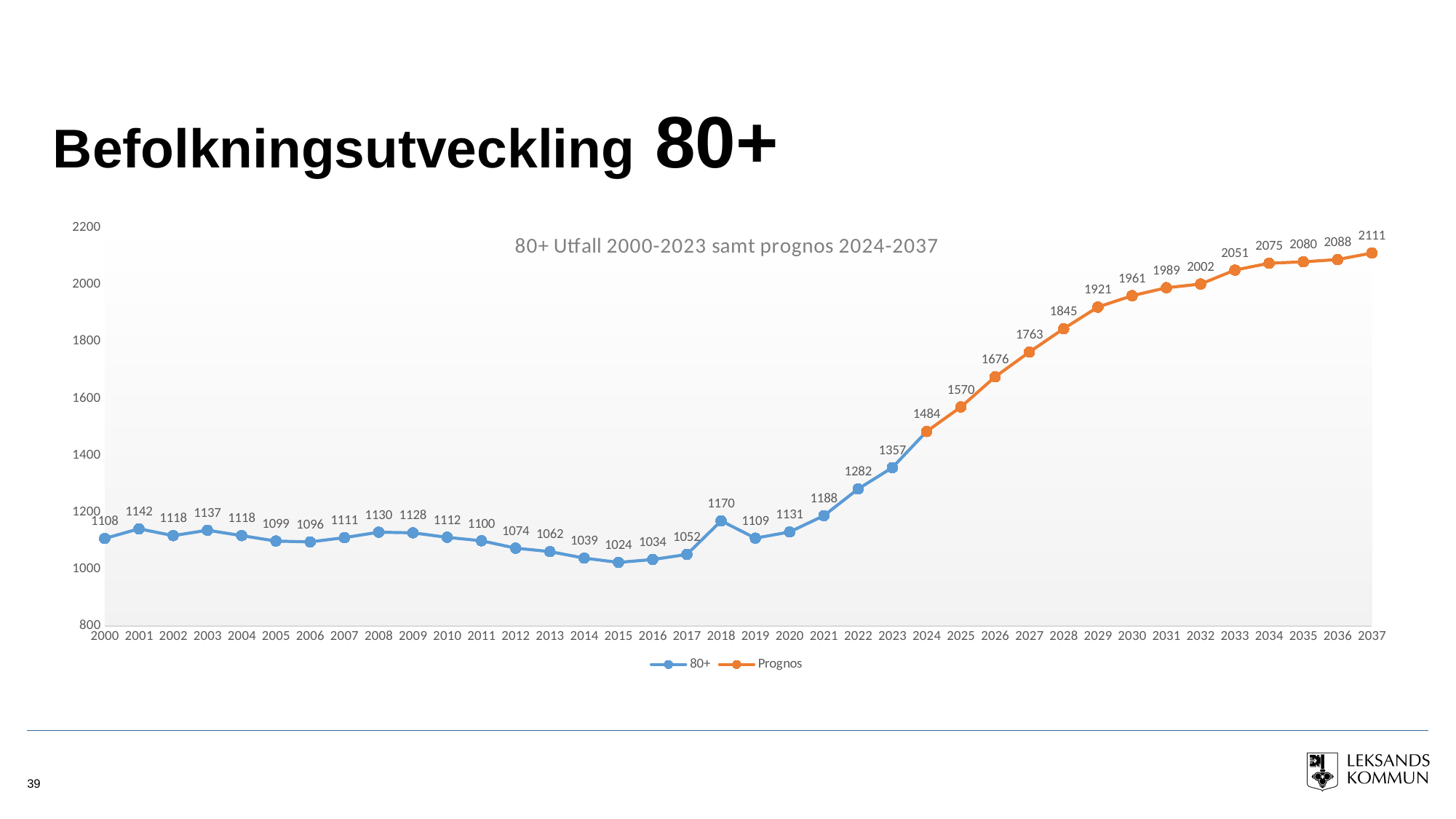
Do the values rise or fall from 2024 to 2037? rise How many series does the legend list? 2 What is the forecast value for 2037? 2111 Which year has the highest value on the chart? 2037 How many years are plotted on the x axis? 38 Is the value for 2028 greater or less than 1800? greater What is the value for 2015? 1024 Which year has the lowest value on the chart? 2015 Which year has the larger value, 2018 or 2019? 2018 What is the difference between the value for 2037 and the value for 2000? 1003 What is the title of the chart? 80+ Utfall 2000-2023 samt prognos 2024-2037 What kind of chart is shown on the slide? line chart